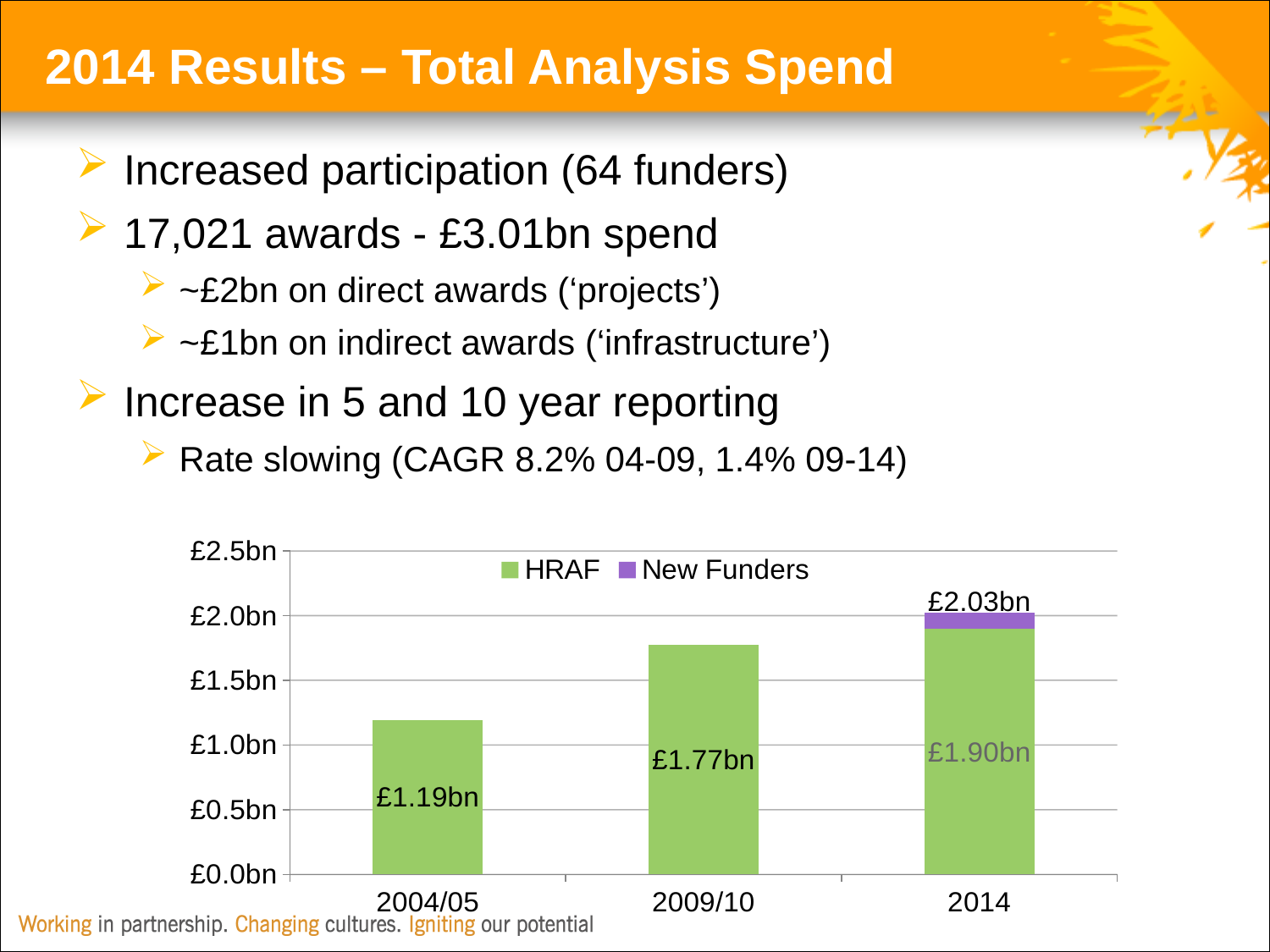
What is the total of the stacked bar for 2014? £2.03bn Which year has the highest HRAF value? 2014 What is the HRAF value for 2009/10? £1.77bn What is the New Funders value for 2014, given the total of £2.03bn and HRAF of £1.90bn? £0.13bn Is the HRAF value for 2009/10 greater or less than £1.5bn? greater What is the HRAF value for 2004/05? £1.19bn Do the HRAF values rise or fall from 2004/05 to 2014? Rise What is the difference between the HRAF values for 2009/10 and 2004/05? £0.58bn What is the HRAF value for 2014? £1.90bn What kind of chart is shown on the slide? Stacked bar chart How many series does the legend list? 2 Which year has the lowest HRAF value? 2004/05